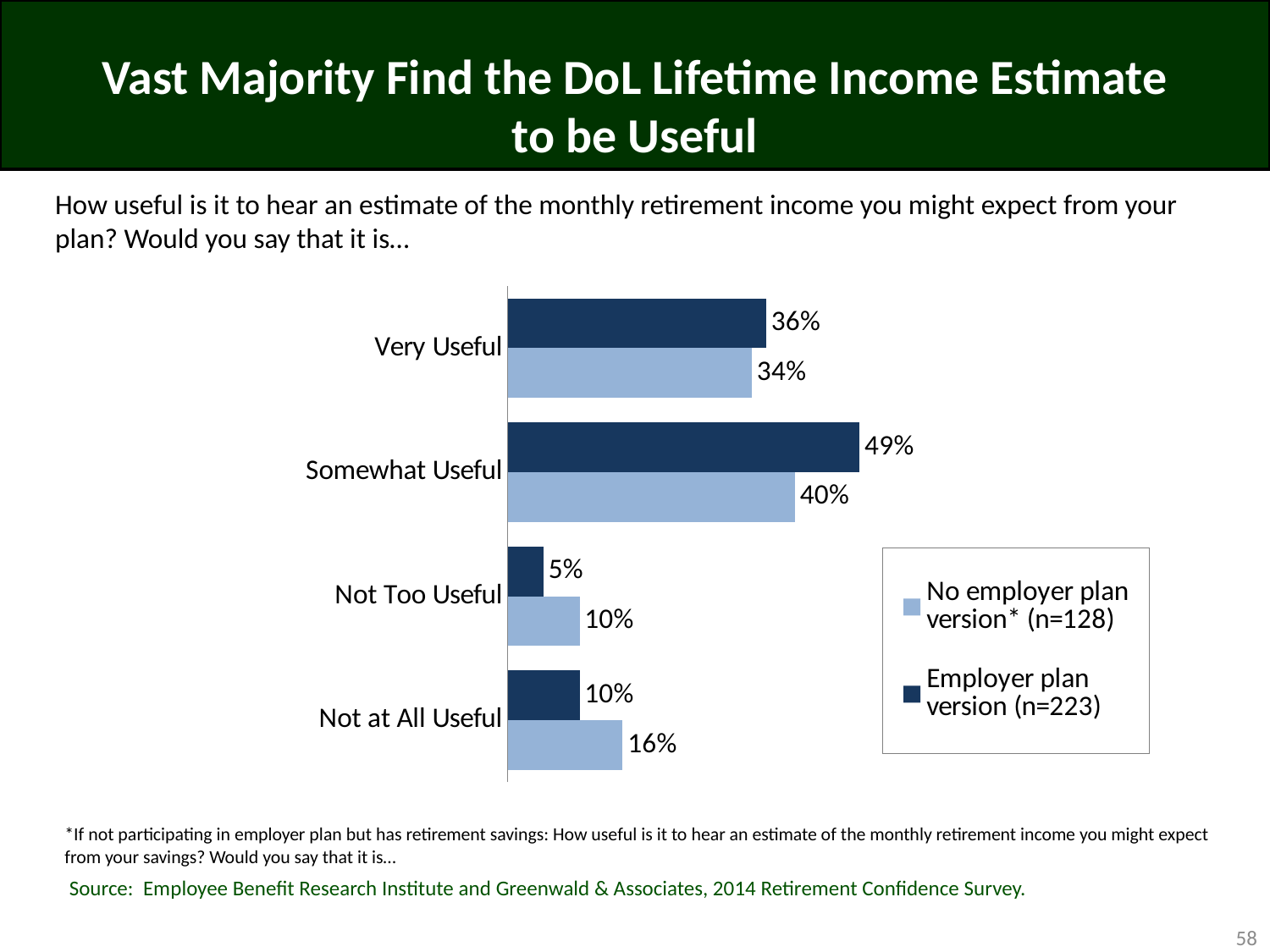
What is the difference between the Employer plan version and No employer plan version values for Somewhat Useful? 9 percentage points Which category has the highest value for the Employer plan version series? Somewhat Useful Which category has the lowest value for the No employer plan version series? Not Too Useful For Not at All Useful, which series has the larger value: Employer plan version or No employer plan version? No employer plan version How many series does the legend list? 2 What is the value for Not Too Useful in the Employer plan version series? 5% What percentage of the No employer plan version respondents said the estimate is Very Useful? 34% What is the value for Not at All Useful in the No employer plan version series? 16% What percentage of the Employer plan version respondents said the estimate is Somewhat Useful? 49% How many response categories are shown on the chart? 4 What type of chart is shown on the slide? Bar chart What is the sample size (n) for the Employer plan version series shown in the legend? 223